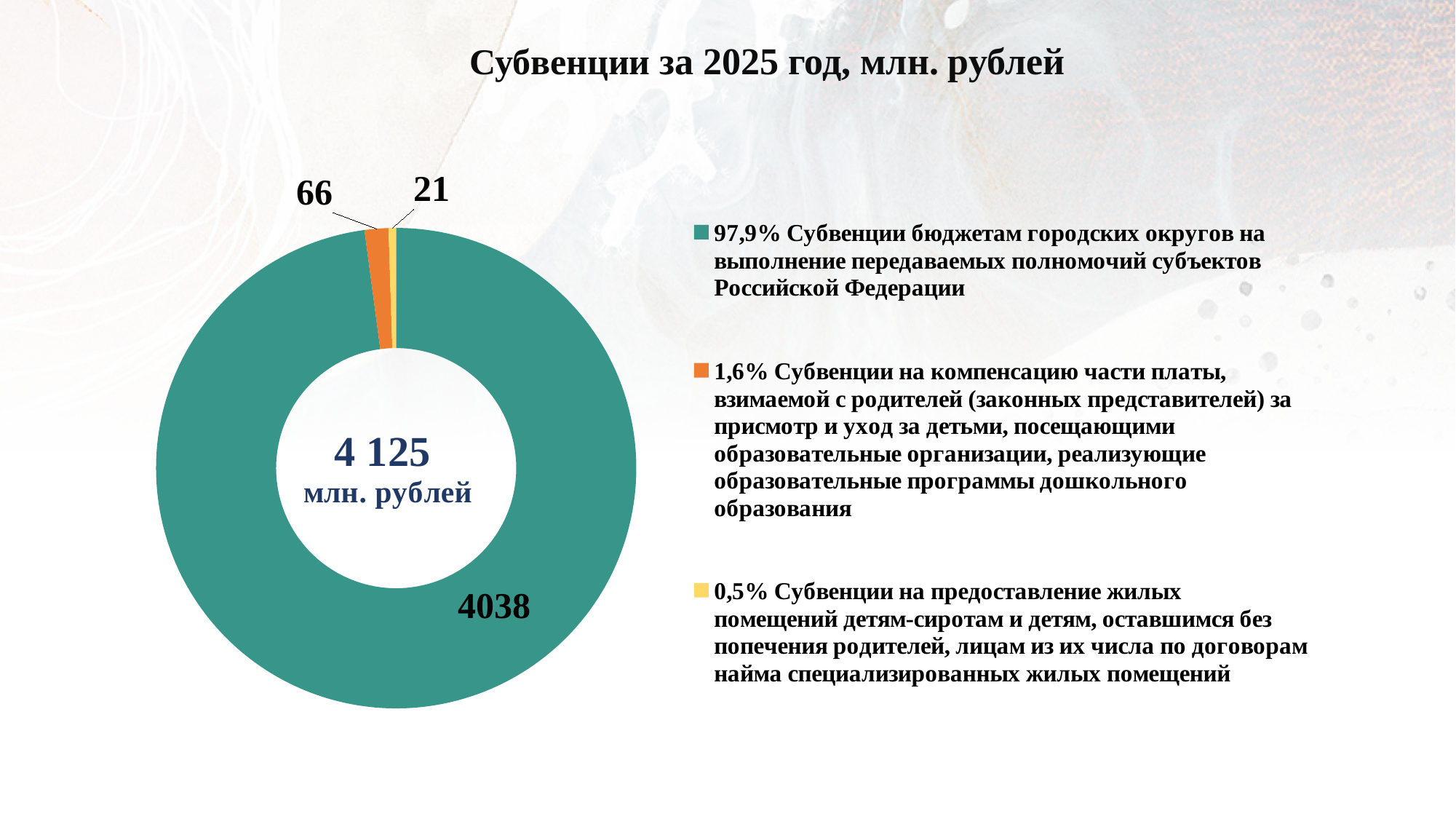
What is the total shown in the centre of the donut chart? 4 125 млн. рублей How many slices does the chart have? 3 Which category has the smallest value? Субвенции на предоставление жилых помещений детям-сиротам и детям, оставшимся без попечения родителей What is the value for Субвенции бюджетам городских округов на выполнение передаваемых полномочий субъектов Российской Федерации? 4038 What is the value for Субвенции на компенсацию части платы, взимаемой с родителей (законных представителей) за присмотр и уход за детьми? 66 What is the title of the chart? Субвенции за 2025 год, млн. рублей How many entries does the legend list? 3 What share of the total do Субвенции на компенсацию части платы, взимаемой с родителей, represent? 1,6% What kind of chart is shown on the slide? Donut (pie) chart Which category has the largest value? Субвенции бюджетам городских округов на выполнение передаваемых полномочий субъектов Российской Федерации What is the difference between the value for Субвенции на компенсацию части платы (66) and the value for Субвенции на предоставление жилых помещений детям-сиротам (21)? 45 What is the value for Субвенции на предоставление жилых помещений детям-сиротам и детям, оставшимся без попечения родителей? 21